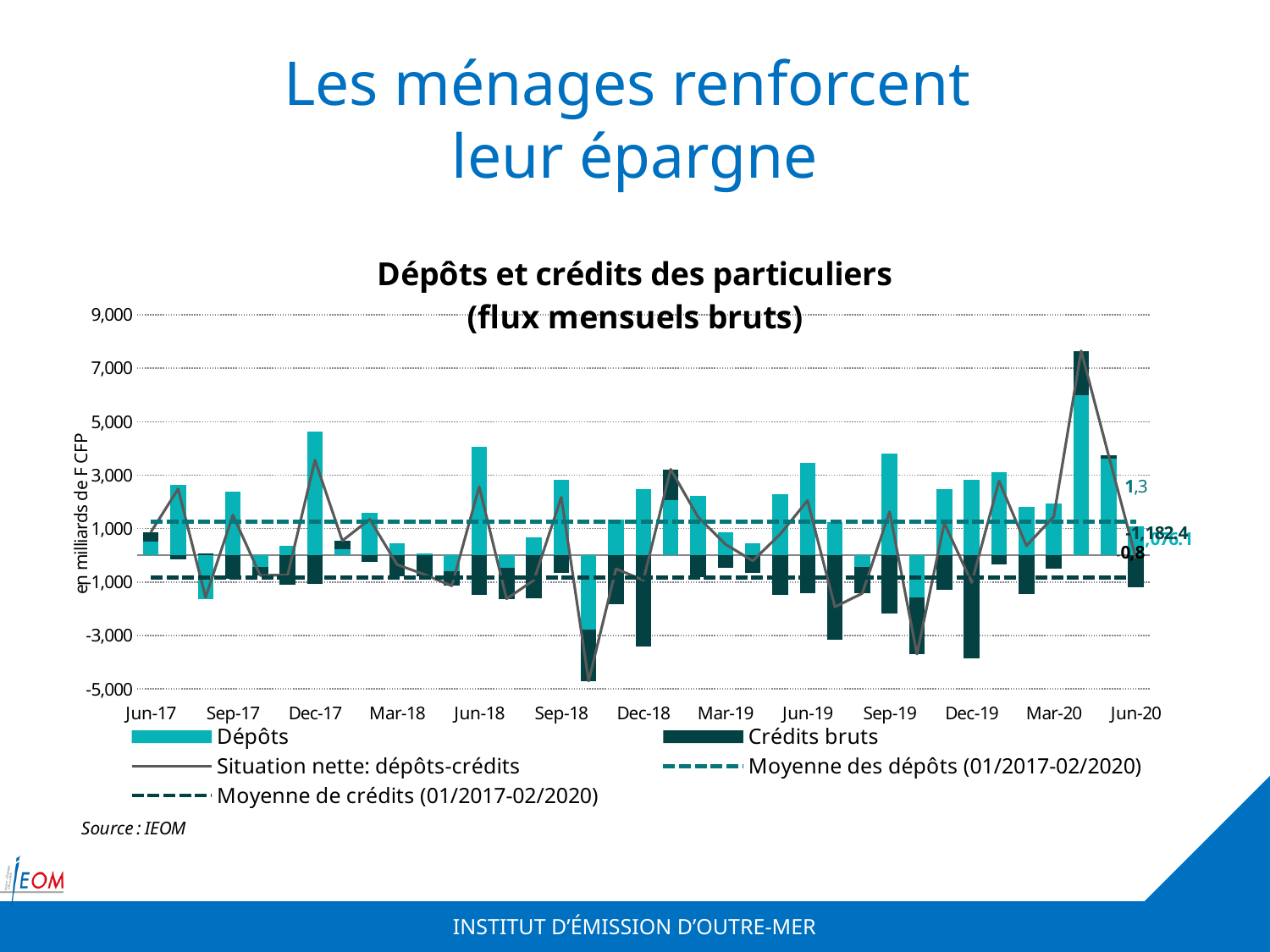
How many date labels are shown along the x axis? 13 What is the title of the chart? Dépôts et crédits des particuliers (flux mensuels bruts) How many series does the chart legend list? 5 What unit is shown on the vertical axis label? en milliards de F CFP What kind of chart is used to show Dépôts and Crédits bruts? bar chart Is the value for Dépôts in Jun-18 greater or less than 3,000? greater Is the Moyenne des dépôts (01/2017-02/2020) line greater or less than 1,000? greater Is the value for Dépôts in Dec-17 greater or less than 3,000? greater Which is larger, the Dépôts value in Dec-17 or in Sep-17? Dec-17